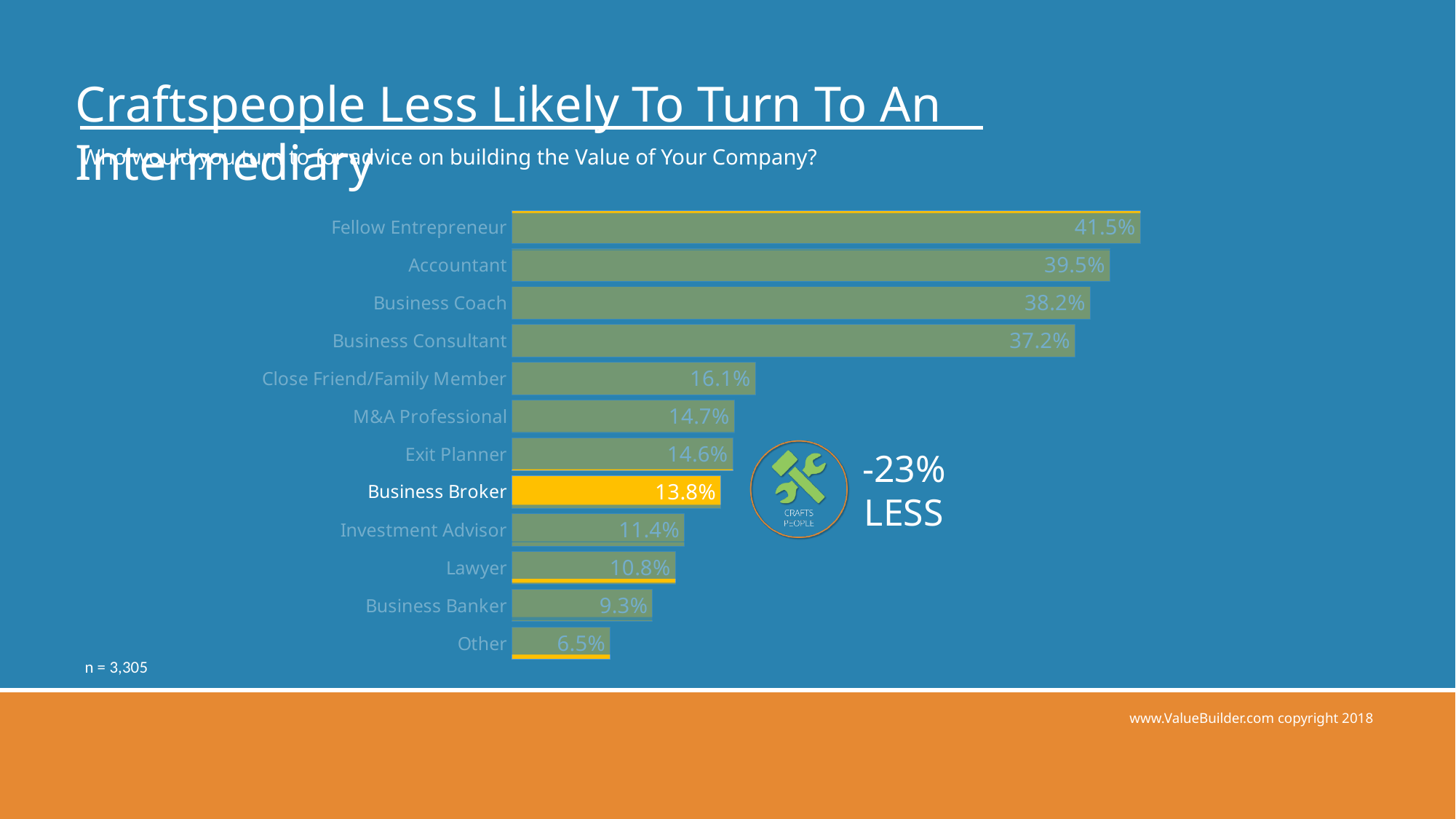
Which is larger, the value for Business Coach or the value for Close Friend/Family Member? Business Coach What is the value shown for Lawyer? 10.8% What is the difference between the values for Accountant and Business Consultant? 2.3% What kind of chart is shown on the slide? Bar chart What is the difference between the values for Business Broker and Investment Advisor? 2.4% What sample size (n) is stated on the slide? n = 3,305 What percentage of respondents would turn to a Fellow Entrepreneur for advice? 41.5% Which category has the lowest value in the chart? Other Which category has the highest value in the chart? Fellow Entrepreneur What is the value shown for Business Broker? 13.8% Which bar is highlighted in a different colour (yellow) from the others? Business Broker How many categories are shown in the bar chart? 12